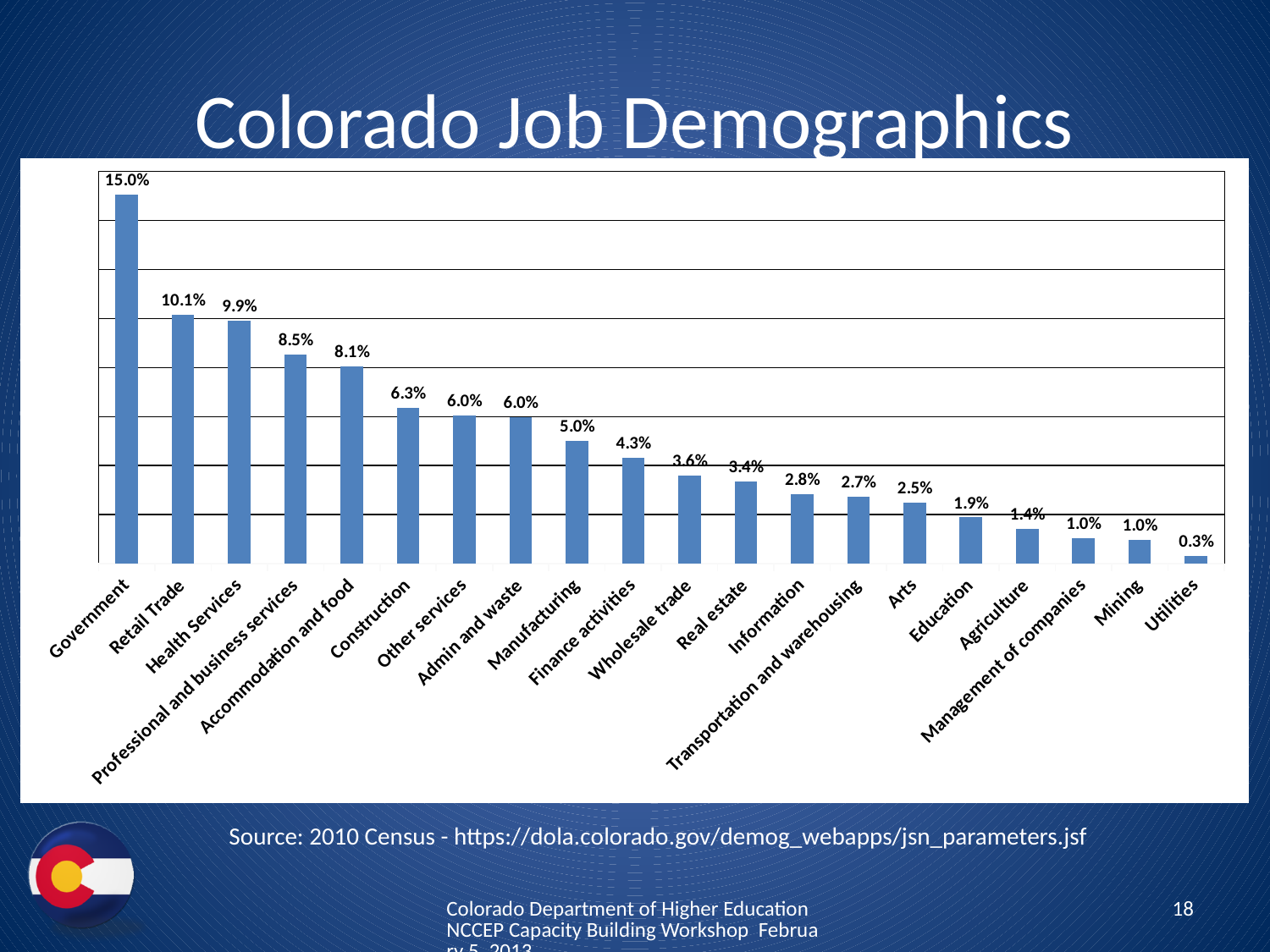
Which is larger, the value for Finance activities or the value for Real estate? Finance activities How many categories are shown in the chart? 20 Which category has the lowest value? Utilities What is the difference between the values for Retail Trade and Manufacturing? 5.1% What is the difference between the values for Government and Health Services? 5.1% What is the value for Transportation and warehousing? 2.7% What is the value for Construction? 6.3% Which category has the highest value? Government Do the values rise or fall from left to right along the x axis? Fall What is the value for Agriculture? 1.4% What kind of chart is shown on the slide? Bar chart What is the value for Government? 15.0%